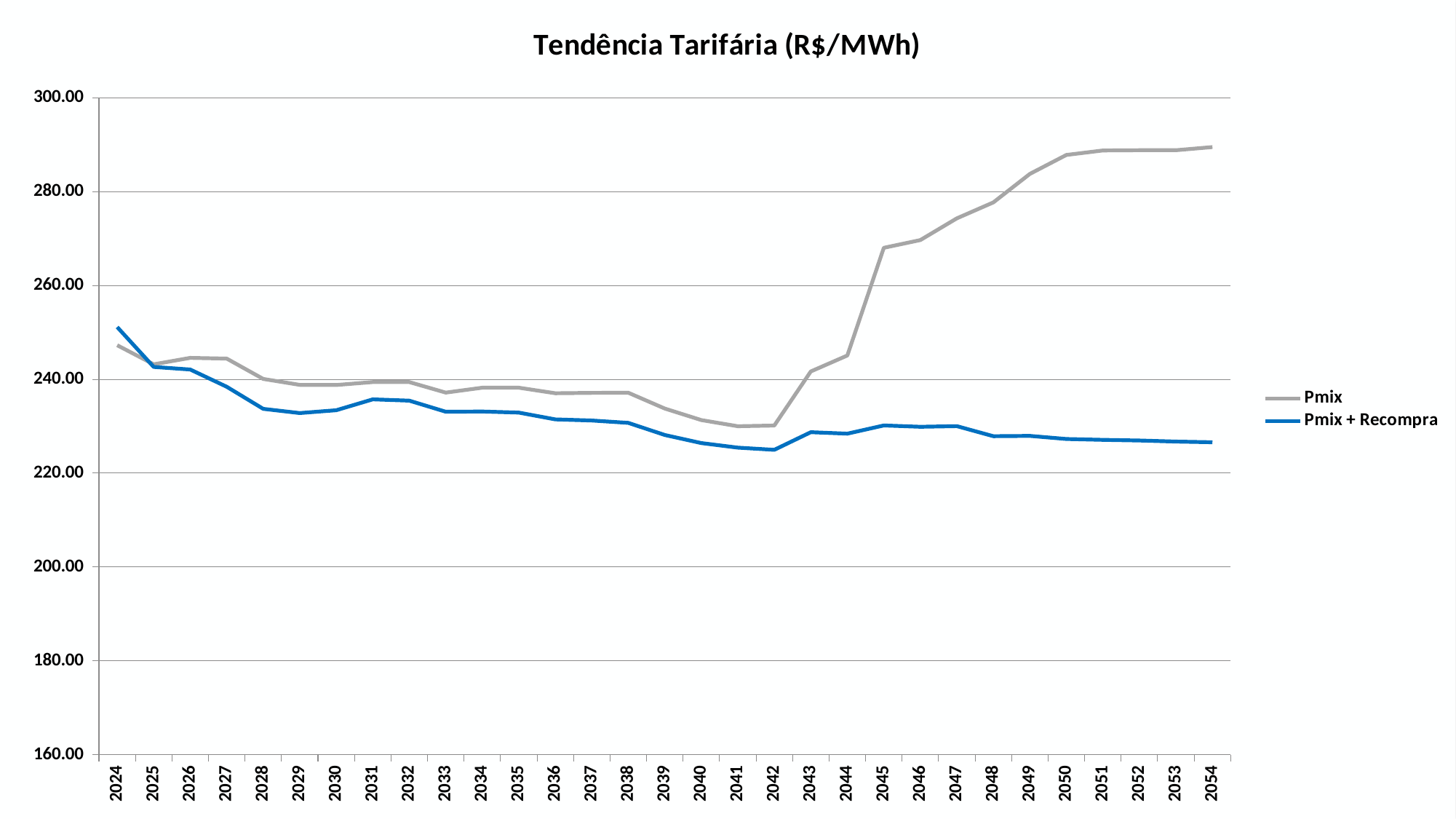
What kind of chart is shown on the slide? line chart Does the Pmix series rise or fall between 2044 and 2050? rise What is the title of the chart? Tendência Tarifária (R$/MWh) How many years are plotted along the x axis? 31 Is the Pmix + Recompra value for 2054 greater or less than 240? less Which series is drawn in blue? Pmix + Recompra Is the Pmix value for 2054 greater or less than 280? greater Is the Pmix value for 2045 greater or less than 260? greater In which year does the Pmix series reach its highest value? 2054 How many series does the legend list? 2 In 2054, which series has the larger value, Pmix or Pmix + Recompra? Pmix